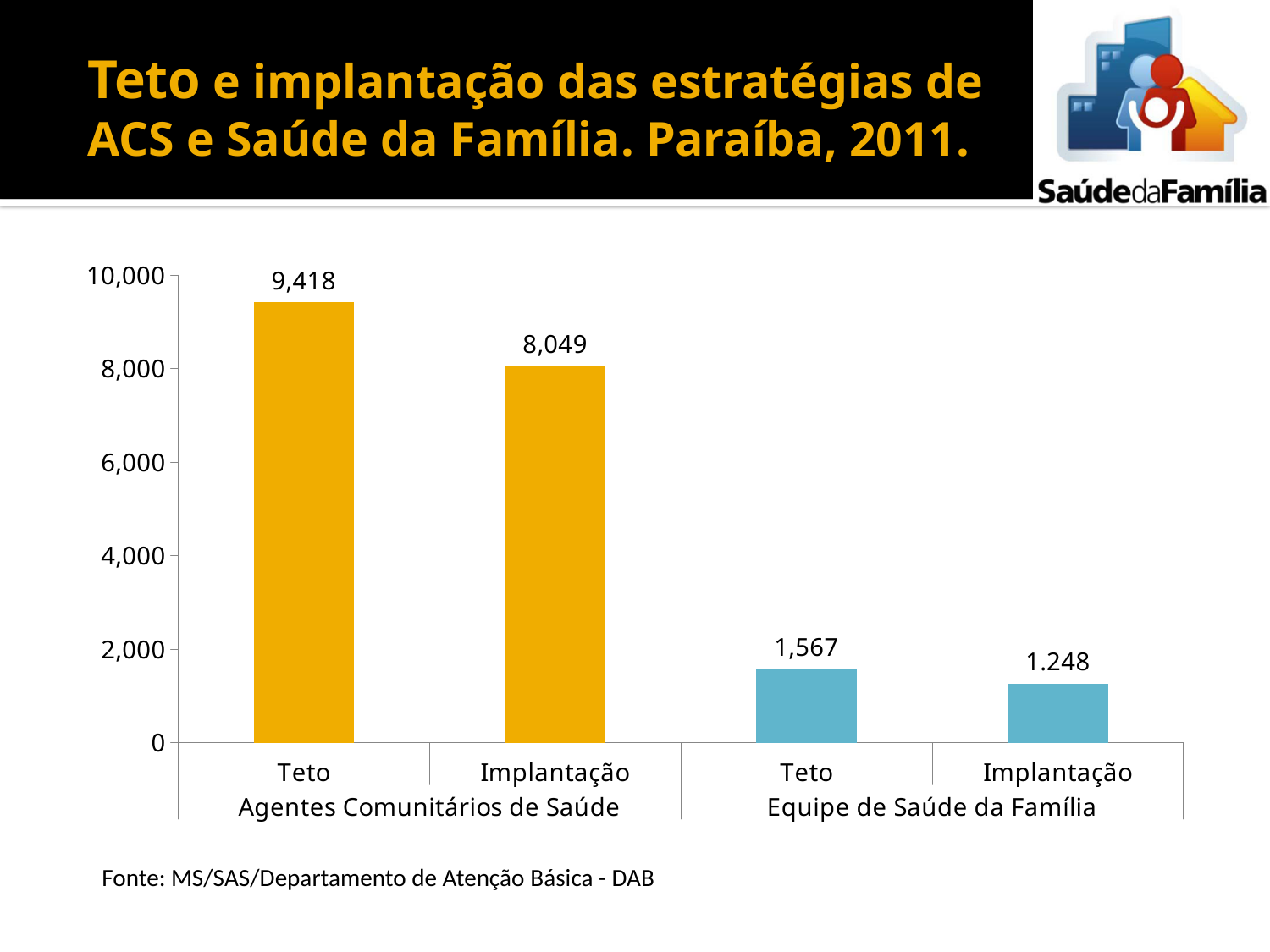
Which bar has the highest value on the chart? Teto (Agentes Comunitários de Saúde) What colour are the bars for Equipe de Saúde da Família? blue Is the value of Implantação for Equipe de Saúde da Família greater or less than 2,000? less Which is larger: Teto for Agentes Comunitários de Saúde or Teto for Equipe de Saúde da Família? Teto for Agentes Comunitários de Saúde What is the difference between Teto and Implantação for Agentes Comunitários de Saúde? 1,369 How many bars are plotted on the chart? 4 What kind of chart is shown on the slide? bar chart What is the value of the Teto bar for Agentes Comunitários de Saúde? 9,418 Which bar has the lowest value on the chart? Implantação (Equipe de Saúde da Família) What is the value of the Teto bar for Equipe de Saúde da Família? 1,567 What is the value of the Implantação bar for Agentes Comunitários de Saúde? 8,049 What is the value of the Implantação bar for Equipe de Saúde da Família? 1.248